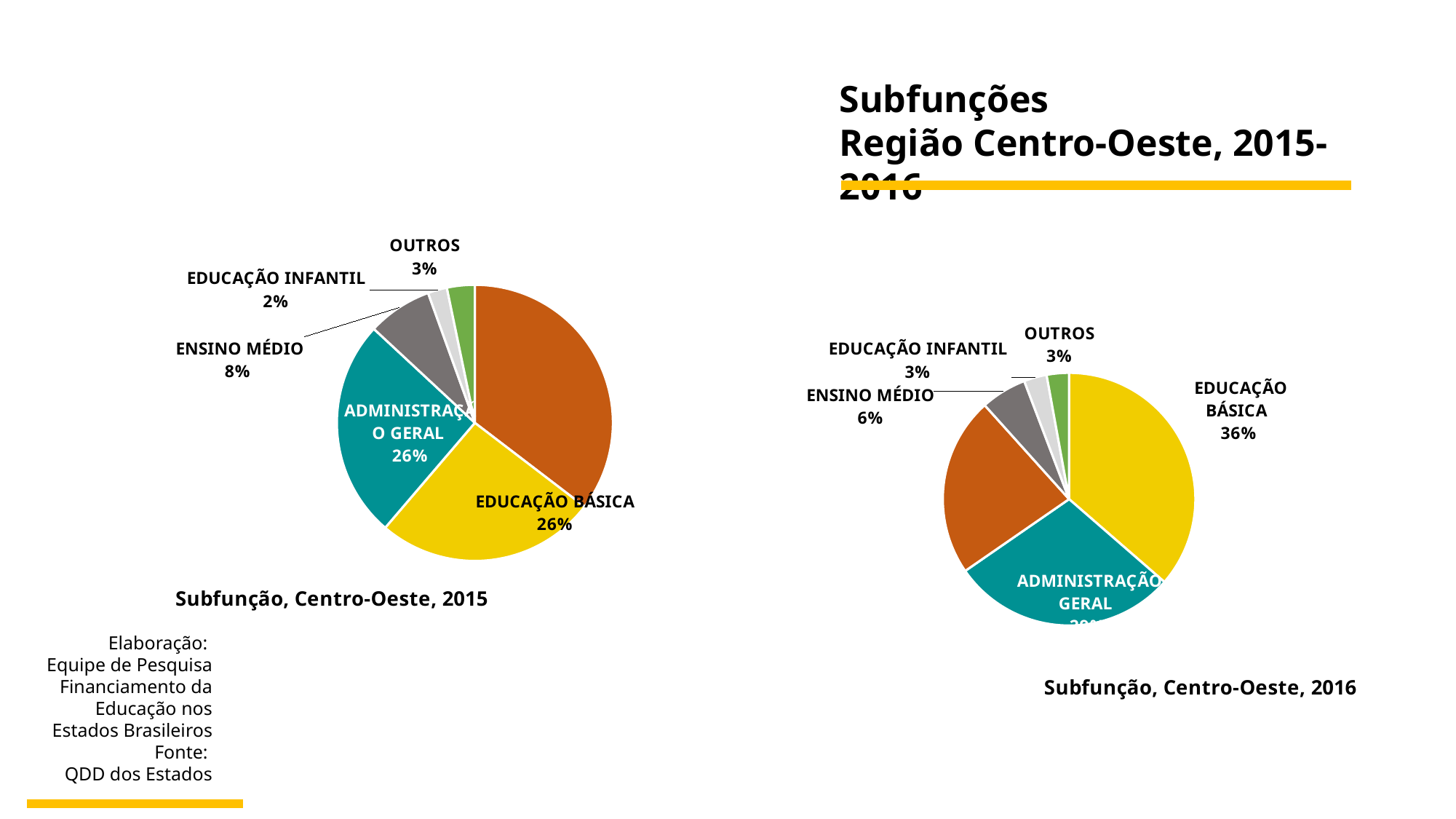
In the chart titled 'Subfunção, Centro-Oeste, 2015', what share does ENSINO MÉDIO have? 8% What type of chart is 'Subfunção, Centro-Oeste, 2016'? Pie chart In the chart titled 'Subfunção, Centro-Oeste, 2016', what share does ENSINO MÉDIO have? 6% Is the share of ENSINO MÉDIO larger in the 2015 chart or in the 2016 chart? 2015 How many slices does the chart titled 'Subfunção, Centro-Oeste, 2015' have? 6 In the chart titled 'Subfunção, Centro-Oeste, 2015', which labelled category has the smallest share? EDUCAÇÃO INFANTIL In the chart titled 'Subfunção, Centro-Oeste, 2015', how many percentage points larger is ENSINO MÉDIO than EDUCAÇÃO INFANTIL? 6 percentage points In the chart titled 'Subfunção, Centro-Oeste, 2016', what share does OUTROS have? 3% In the chart titled 'Subfunção, Centro-Oeste, 2015', what share does EDUCAÇÃO BÁSICA have? 26% How many charts are shown on the slide? 2 In the chart titled 'Subfunção, Centro-Oeste, 2015', what share does EDUCAÇÃO INFANTIL have? 2% In the chart titled 'Subfunção, Centro-Oeste, 2016', what share does EDUCAÇÃO BÁSICA have? 36%